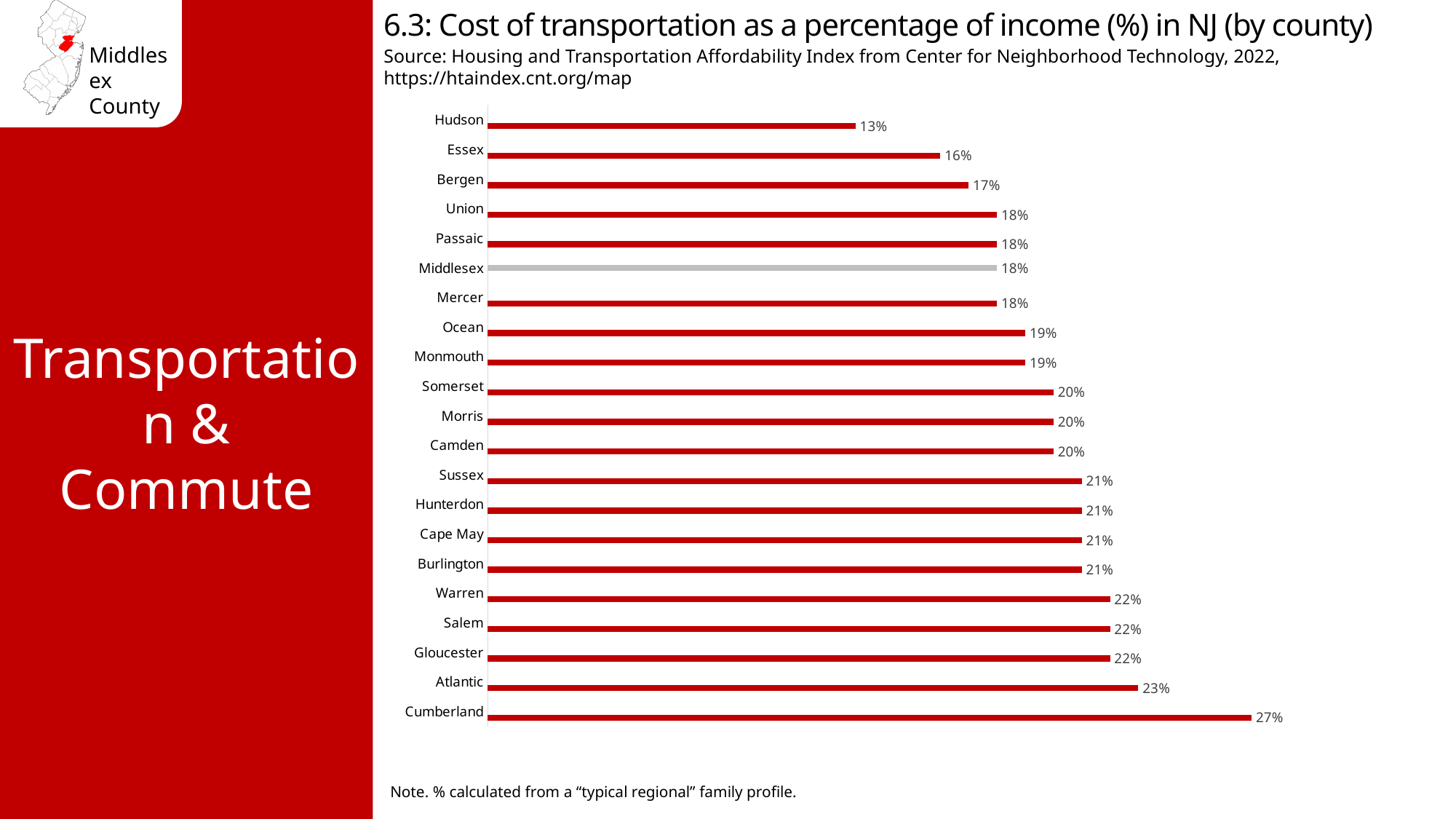
How many counties are shown in the chart? 21 Which county's bar is shown in a different colour (grey) from the others? Middlesex What kind of chart is shown on the slide? Bar chart What is the cost of transportation as a percentage of income for Cumberland County? 27% What is the cost of transportation as a percentage of income for Atlantic County? 23% What is the difference in percentage points between Cumberland and Hudson? 14 What is the cost of transportation as a percentage of income for Middlesex County? 18% Which county has the lowest cost of transportation as a percentage of income? Hudson Which county has a higher cost of transportation as a percentage of income, Bergen or Somerset? Somerset What is the difference in percentage points between Middlesex and Essex? 2 Which county has the highest cost of transportation as a percentage of income? Cumberland What is the cost of transportation as a percentage of income for Hudson County? 13%